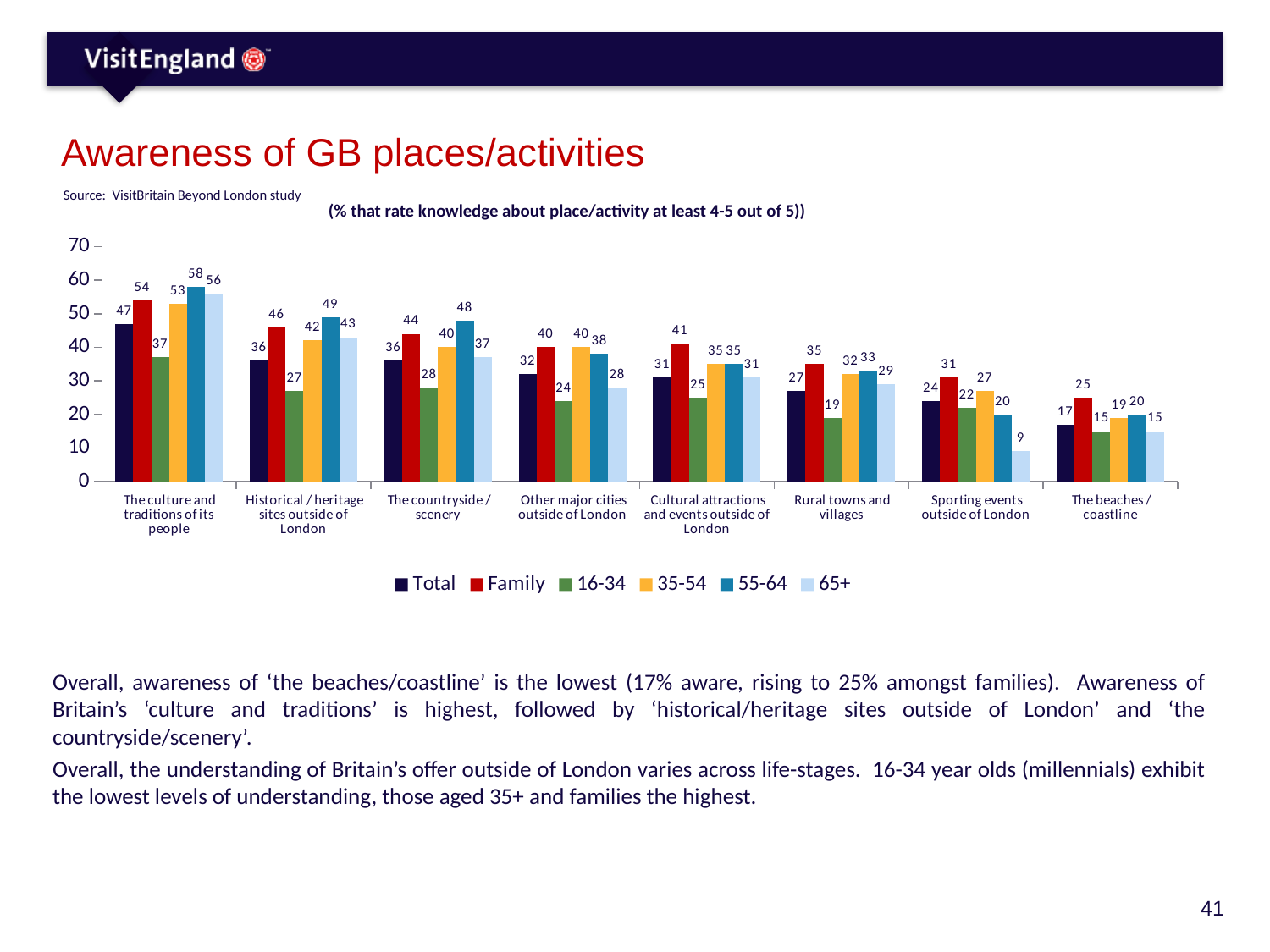
What is the Family value for 'The beaches / coastline'? 25 Which category has the highest Total value? The culture and traditions of its people What is the difference between the 55-64 and 16-34 values for 'The culture and traditions of its people'? 21 What kind of chart is shown on the slide? Bar chart Which is larger for 'Historical / heritage sites outside of London': the Family value or the 35-54 value? Family What is the subtitle shown above the chart? (% that rate knowledge about place/activity at least 4-5 out of 5)) What is the 65+ value for 'Sporting events outside of London'? 9 Which category has the lowest Total value? The beaches / coastline What is the 16-34 value for 'Rural towns and villages'? 19 How many categories are shown on the x axis? 8 What is the Total value for 'The culture and traditions of its people'? 47 How many series does the legend list? 6